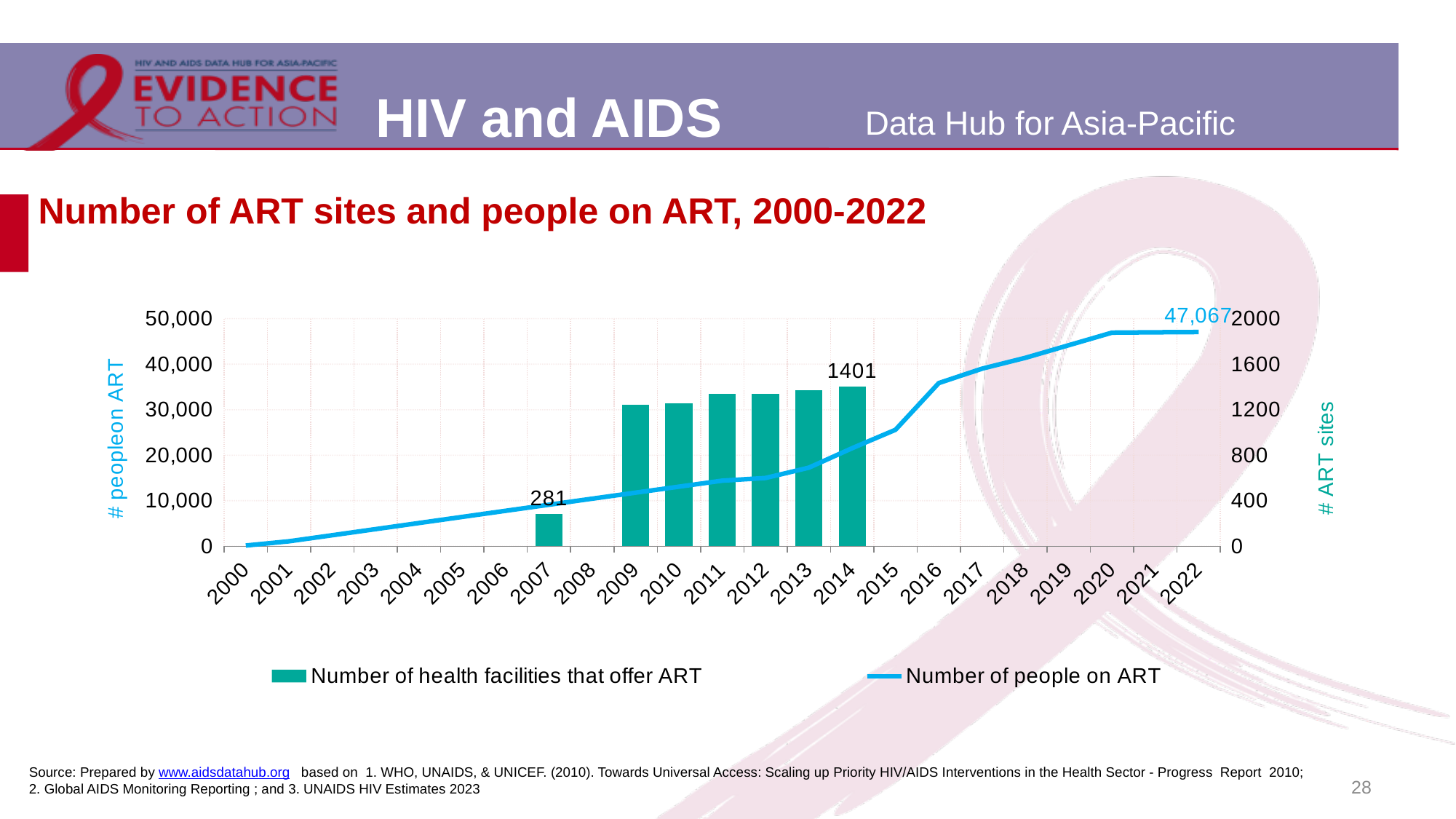
How many series does the legend list? 2 What is the number of health facilities that offer ART in 2014? 1401 Does the number of people on ART rise or fall from 2000 to 2022? Rise Is the number of people on ART in 2016 greater or less than 30,000? greater What is the difference between the number of health facilities that offer ART in 2014 and in 2007? 1120 Which year has the lowest number of health facilities that offer ART among the years with a bar? 2007 Which year has the highest number of health facilities that offer ART? 2014 How many years are shown on the x axis? 23 Is the number of people on ART in 2010 greater or less than 20,000? less What is the number of people on ART in 2022? 47,067 What kind of chart is this? Combined bar and line chart What is the number of health facilities that offer ART in 2007? 281